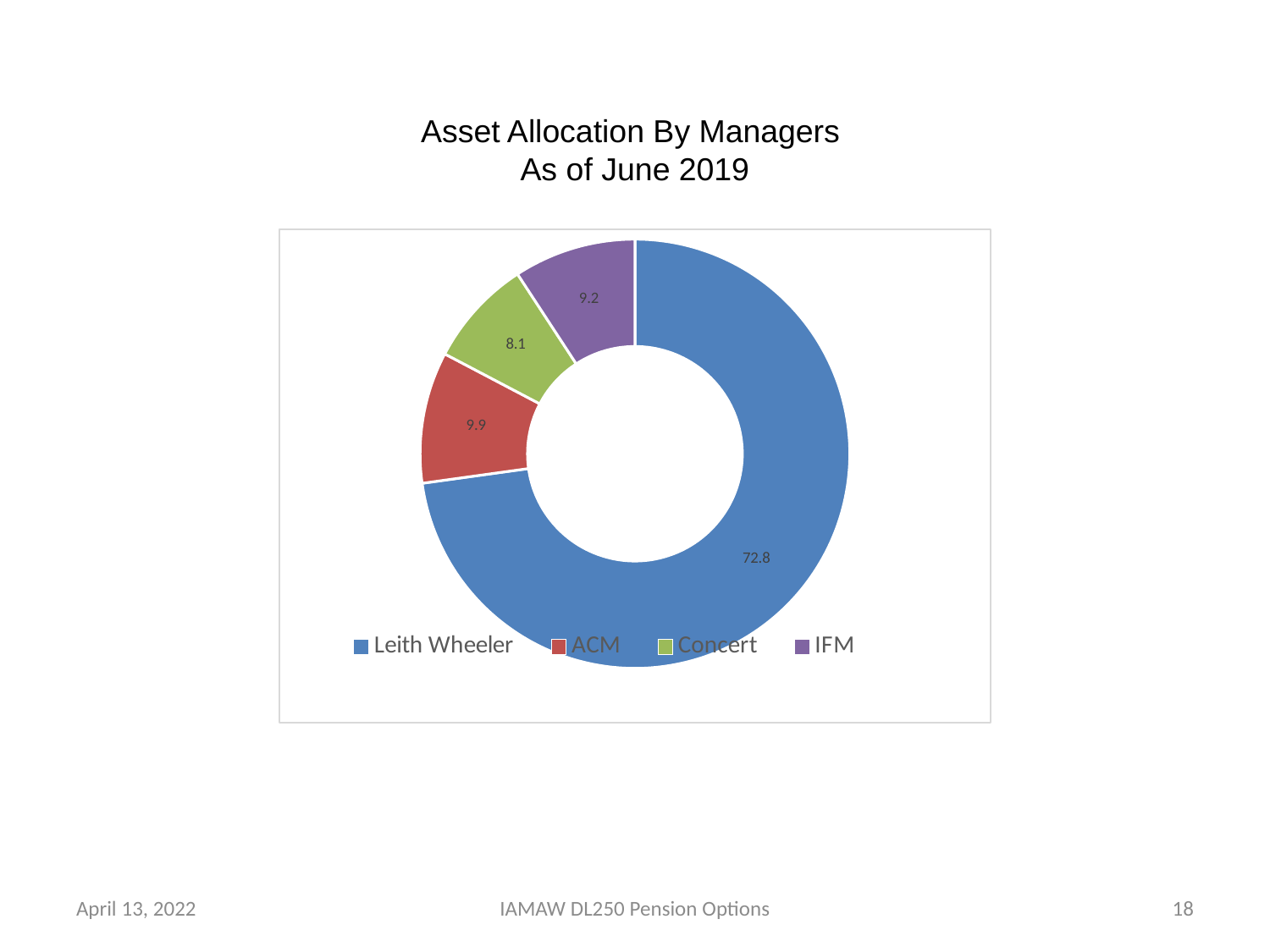
What is the value shown for Leith Wheeler? 72.8 Which manager has the smallest slice of the chart? Concert What is the value shown for Concert? 8.1 What is the title of the chart? Asset Allocation By Managers As of June 2019 What is the value shown for IFM? 9.2 Which manager has the largest slice of the chart? Leith Wheeler How many managers are shown in the chart? 4 Which is larger, the value for ACM or the value for IFM? ACM What is the difference between the values for IFM and Concert? 1.1 What is the value shown for ACM? 9.9 What is the difference between the values for Leith Wheeler and ACM? 62.9 What kind of chart is shown on the slide? doughnut chart